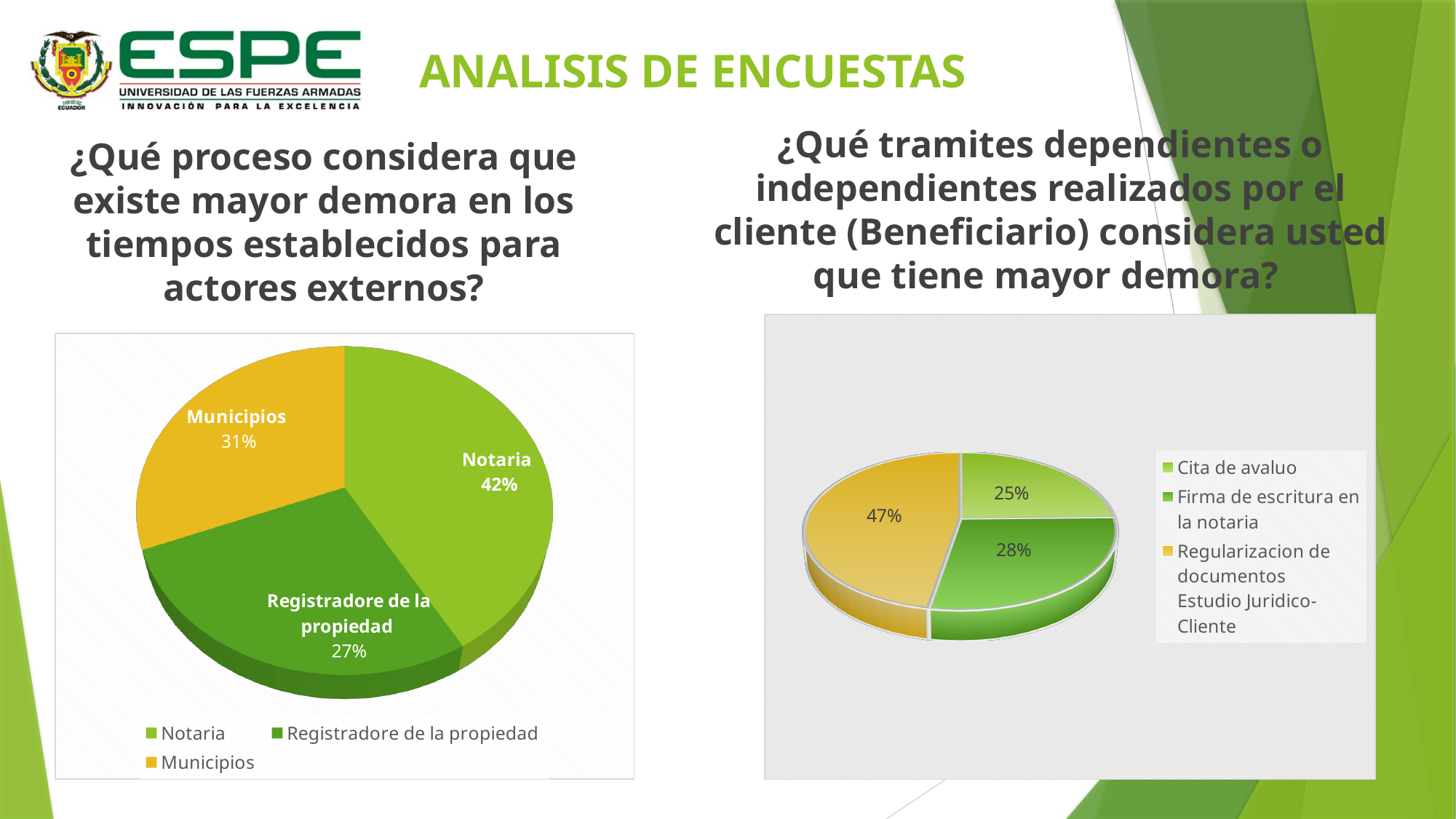
In the right pie chart, what percentage is shown for Firma de escritura en la notaria? 28% In the left pie chart, what percentage is shown for Municipios? 31% In the left pie chart, which category has the largest share? Notaria In the left pie chart, what percentage is shown for Registradore de la propiedad? 27% In the right pie chart, which category has the largest share? Regularizacion de documentos Estudio Juridico-Cliente In the right pie chart, which is larger: Cita de avaluo or Firma de escritura en la notaria? Firma de escritura en la notaria In the left pie chart, what percentage is shown for Notaria? 42% What type of chart is used on the right side of the slide? Pie chart In the right pie chart, what percentage is shown for Cita de avaluo? 25% In the left pie chart, what is the difference in percentage points between Notaria and Municipios? 11 In the left pie chart, which category has the smallest share? Registradore de la propiedad In the left pie chart, how many categories are shown? 3